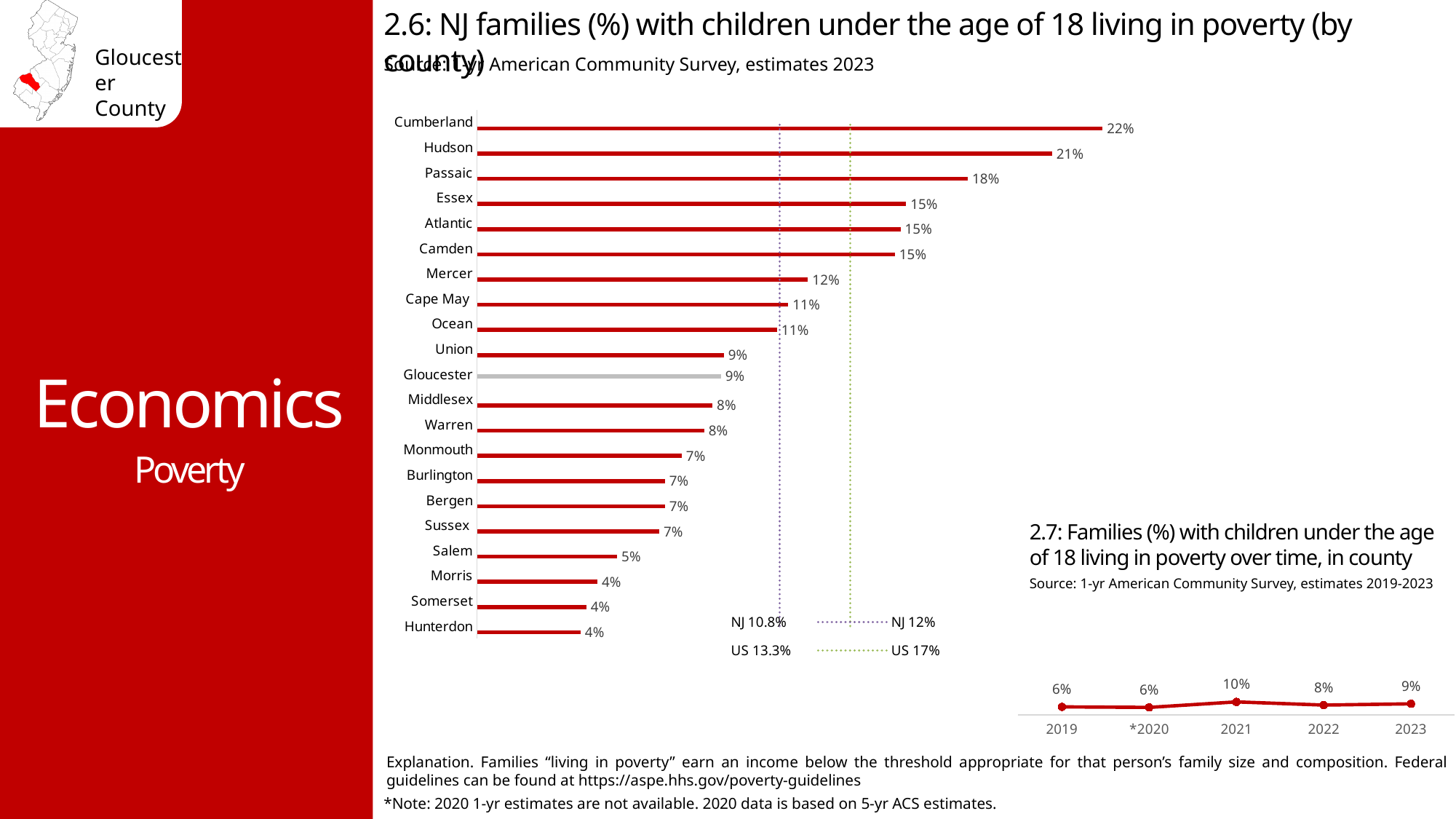
In chart 2.6, which has a higher value, Passaic or Mercer? Passaic In chart 2.6, what is the difference between the values for Cumberland and Gloucester? 13% In chart 2.7, which year has the highest value? 2021 In chart 2.6, what is the value shown for Hudson County? 21% In chart 2.7, how many years are plotted? 5 What kind of chart is chart 2.6? Bar chart In chart 2.7, what is the difference between the values for 2023 and 2019? 3% In chart 2.6, which county has the highest percentage of families with children under 18 living in poverty? Cumberland In chart 2.7, what is the value for 2021? 10% In chart 2.6, what percentage of families with children under 18 live in poverty in Gloucester County? 9% In chart 2.6, how many counties are plotted? 21